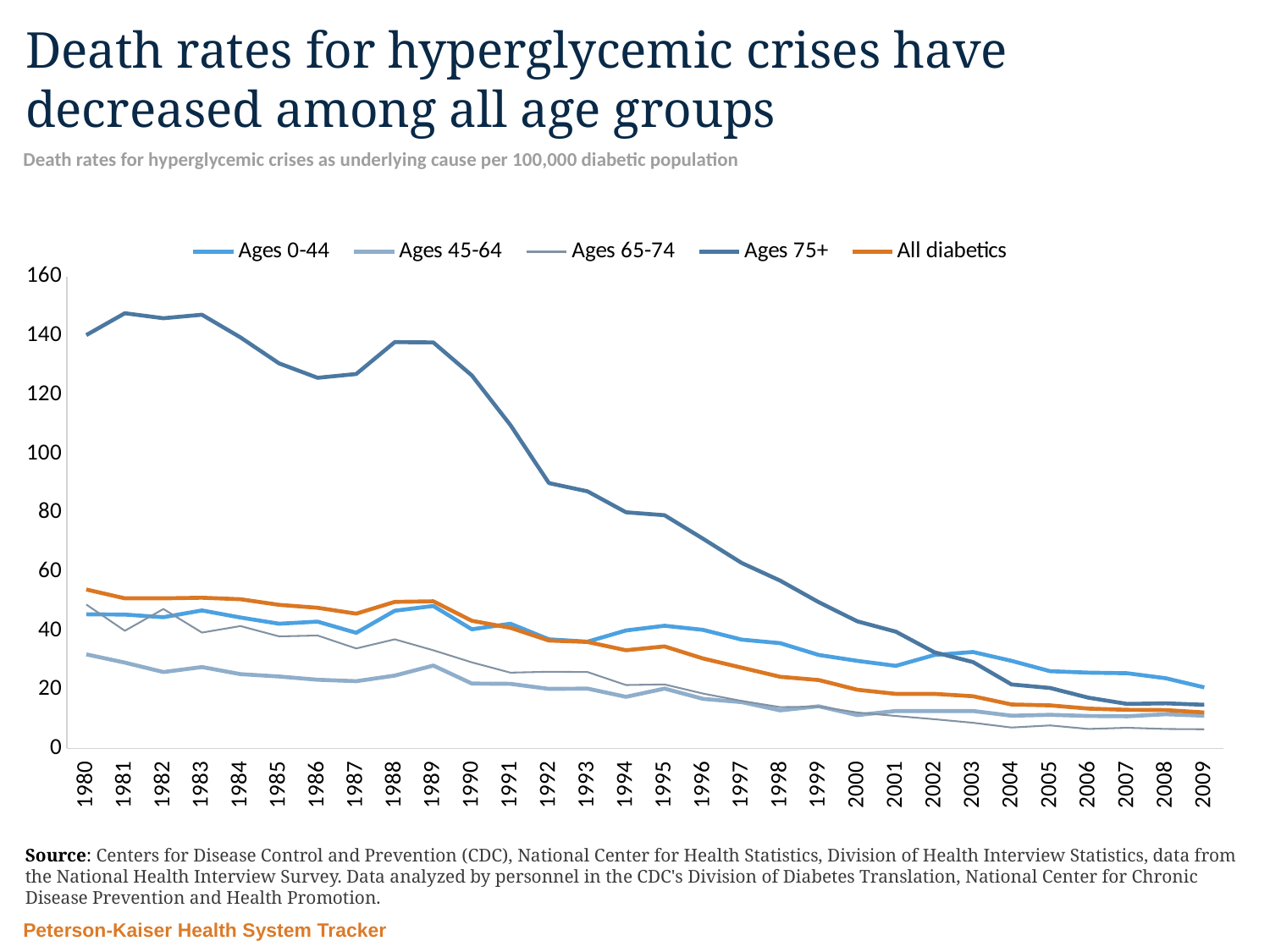
How many years are shown along the x axis? 30 Which age group has the lowest death rate in 1980? Ages 45-64 Is the value for All diabetics in 1980 greater or less than 60? less Is the value for Ages 75+ in 1981 greater or less than 140? greater What kind of chart is shown on the slide? line chart Which is larger in 2005, the value for Ages 0-44 or the value for Ages 65-74? Ages 0-44 What is the first year shown on the x axis? 1980 How many series does the legend list? 5 Is the value for Ages 75+ in 1992 greater or less than 100? less Does the death rate for Ages 75+ rise or fall from 1980 to 2009? fall Which age group has the highest death rate in 1980? Ages 75+